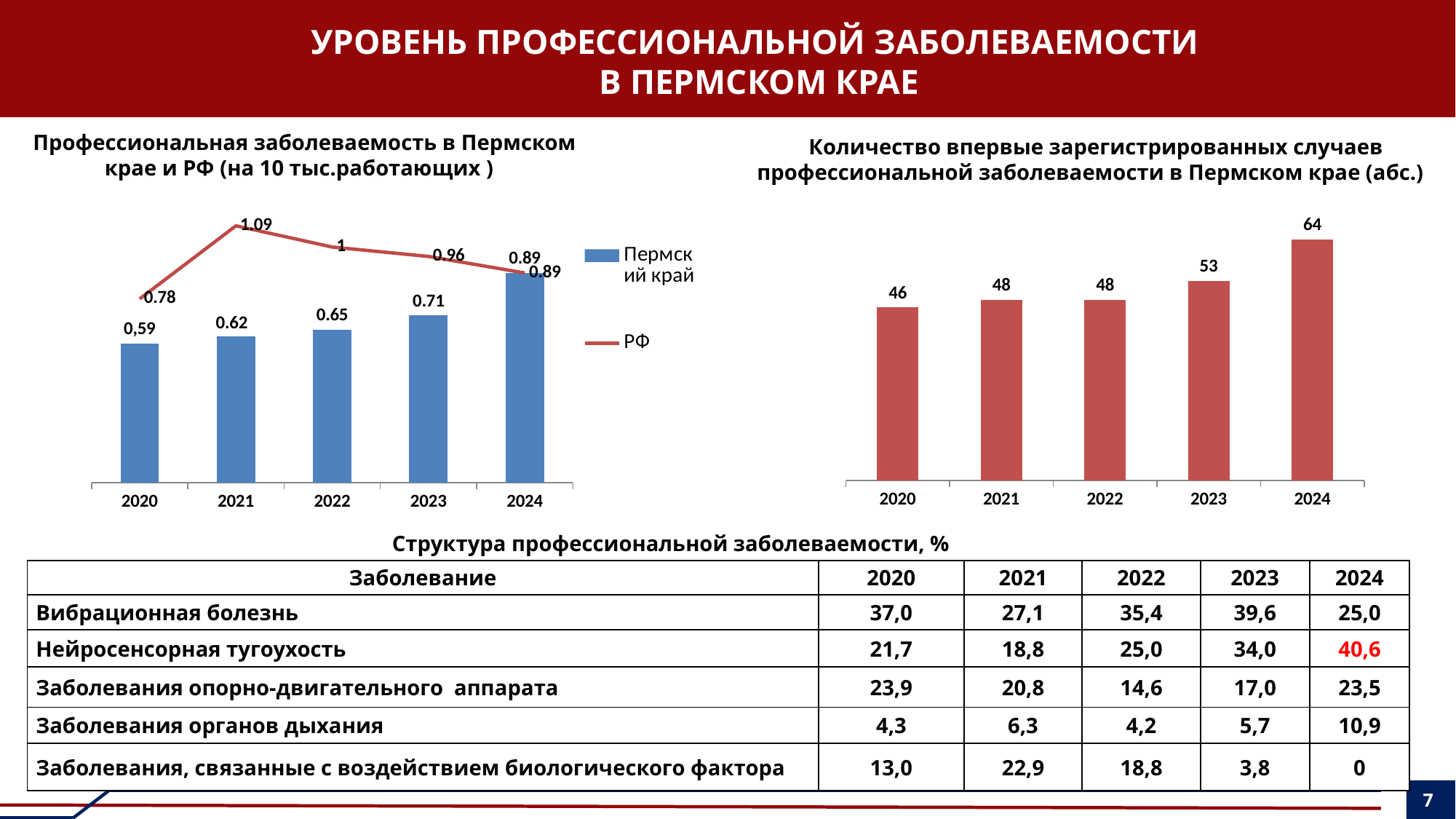
In the right chart (Количество впервые зарегистрированных случаев), what is the difference between the 2024 and 2020 values? 18 In the left chart (Профессиональная заболеваемость в Пермском крае и РФ), which is larger in 2022: the Пермский край value or the РФ value? РФ In the right chart (Количество впервые зарегистрированных случаев), how many years are shown on the x axis? 5 In the left chart (Профессиональная заболеваемость в Пермском крае и РФ), in which year is the Пермский край value lowest? 2020 In the right chart (Количество впервые зарегистрированных случаев), which year has the highest value? 2024 In the right chart (Количество впервые зарегистрированных случаев), what is the value for 2023? 53 In the left chart (Профессиональная заболеваемость в Пермском крае и РФ), how many series does the legend list? 2 In the left chart (Профессиональная заболеваемость в Пермском крае и РФ), what is the value for РФ in 2021? 1.09 In the left chart (Профессиональная заболеваемость в Пермском крае и РФ), in which year is the РФ value highest? 2021 In the left chart (Профессиональная заболеваемость в Пермском крае и РФ), what is the value for Пермский край in 2023? 0.71 What kind of chart is the right chart (Количество впервые зарегистрированных случаев)? bar chart In the left chart (Профессиональная заболеваемость в Пермском крае и РФ), do the Пермский край values rise or fall from 2020 to 2024? rise